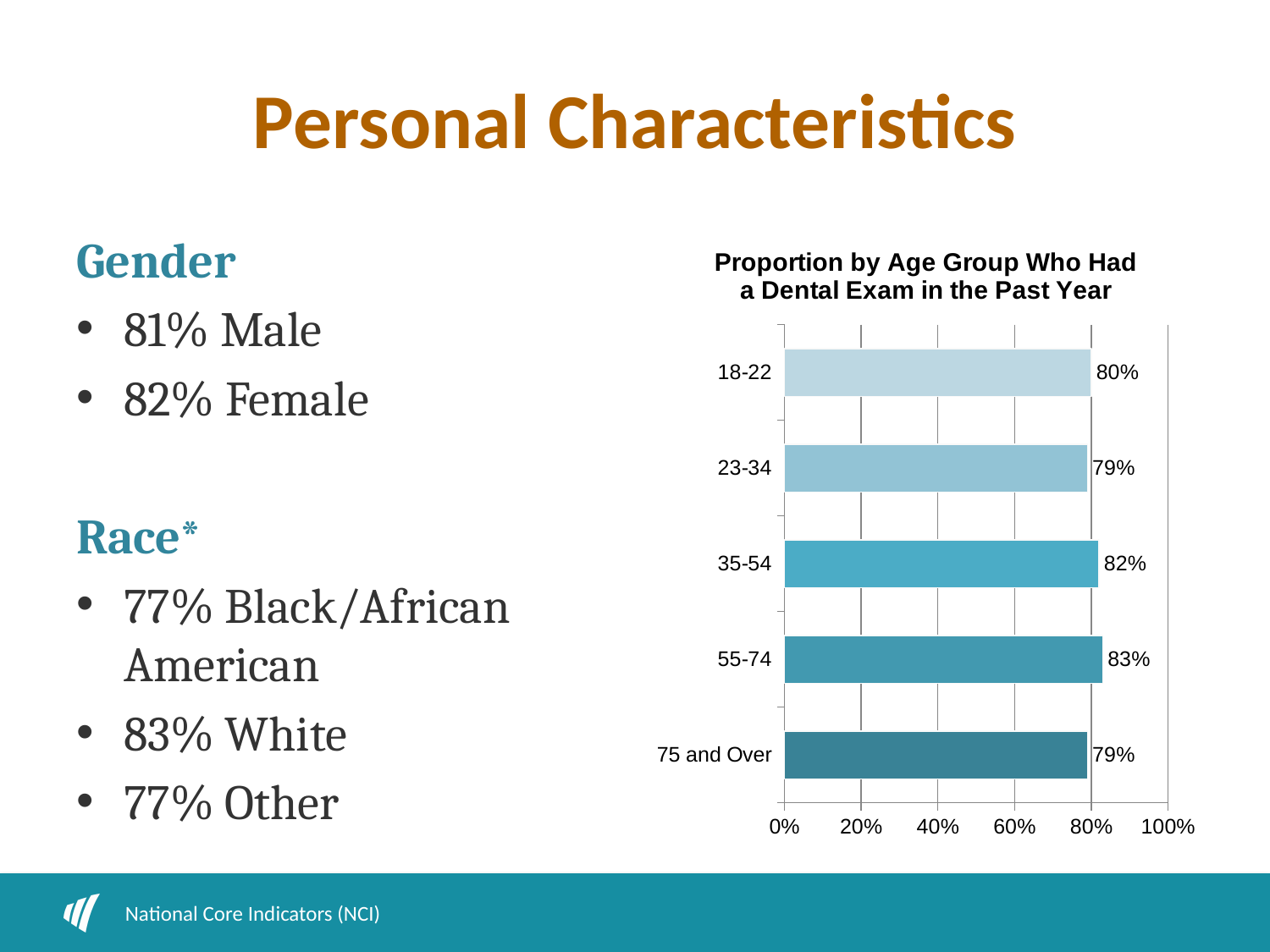
What is the title of the chart? Proportion by Age Group Who Had a Dental Exam in the Past Year What is the value for the 55-74 age group? 83% Which is larger, the value for 35-54 or the value for 18-22? 35-54 How many age groups are shown in the chart? 5 Is the value for 23-34 greater or less than 60%? greater What is the maximum value shown on the chart's horizontal axis? 100% What is the value for the 18-22 age group? 80% Which age group has the highest proportion who had a dental exam in the past year? 55-74 What is the value for the 75 and Over age group? 79% What kind of chart is shown on the slide? Bar chart What is the value for the 35-54 age group? 82% What is the difference between the values for 55-74 and 23-34? 4%